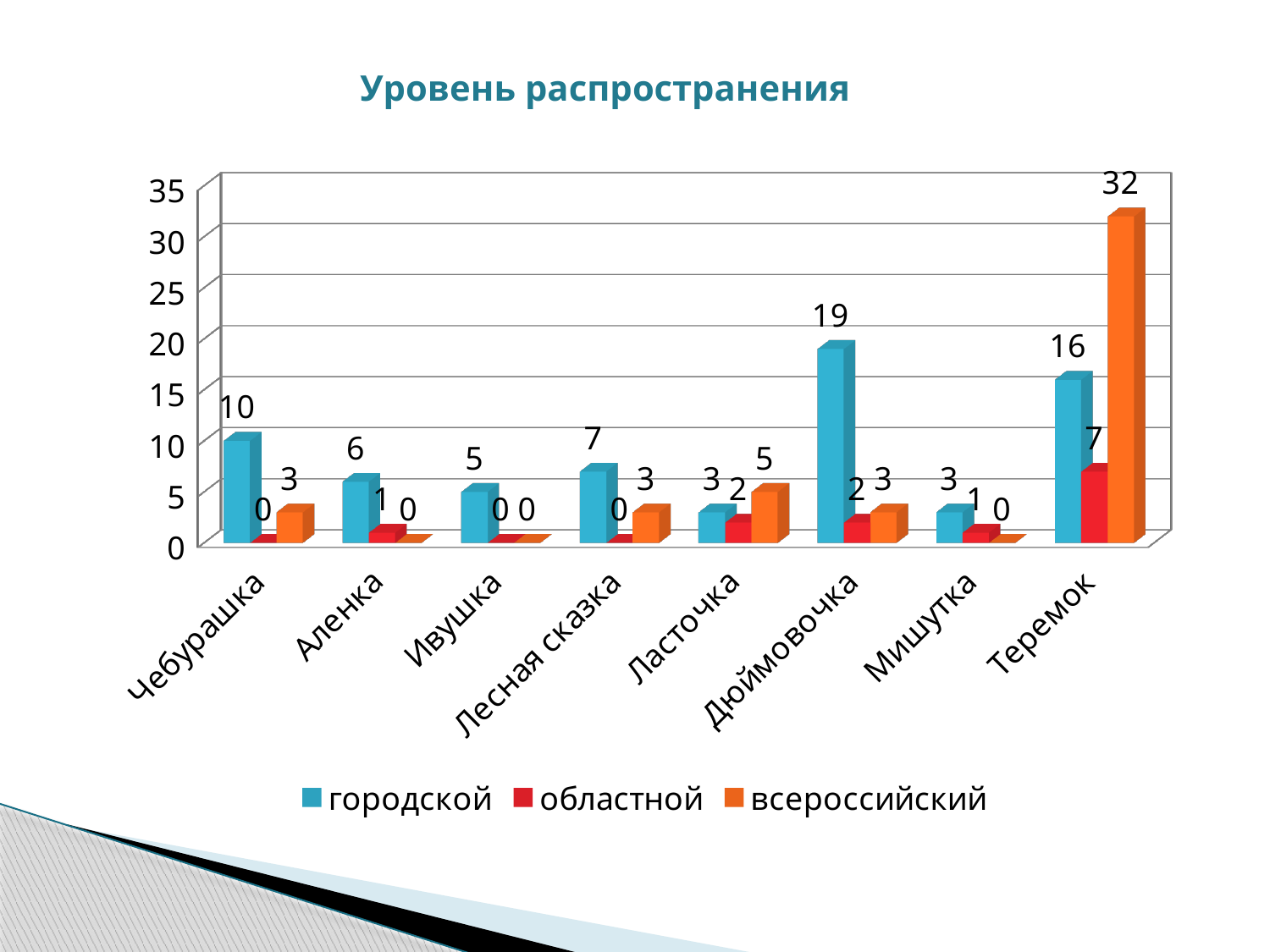
What is the value for областной for Ласточка? 2 What is the title of the chart? Уровень распространения Which is larger: the всероссийский value for Ласточка or the всероссийский value for Чебурашка? Ласточка Which category has the highest value for областной? Теремок How many series does the legend list? 3 What is the value for всероссийский for Теремок? 32 What is the difference between the городской values for Дюймовочка and Теремок? 3 What is the value for городской for Дюймовочка? 19 Which series is shown in orange? всероссийский Which category has the highest value for городской? Дюймовочка How many categories are shown on the x axis? 8 What kind of chart is shown? bar chart